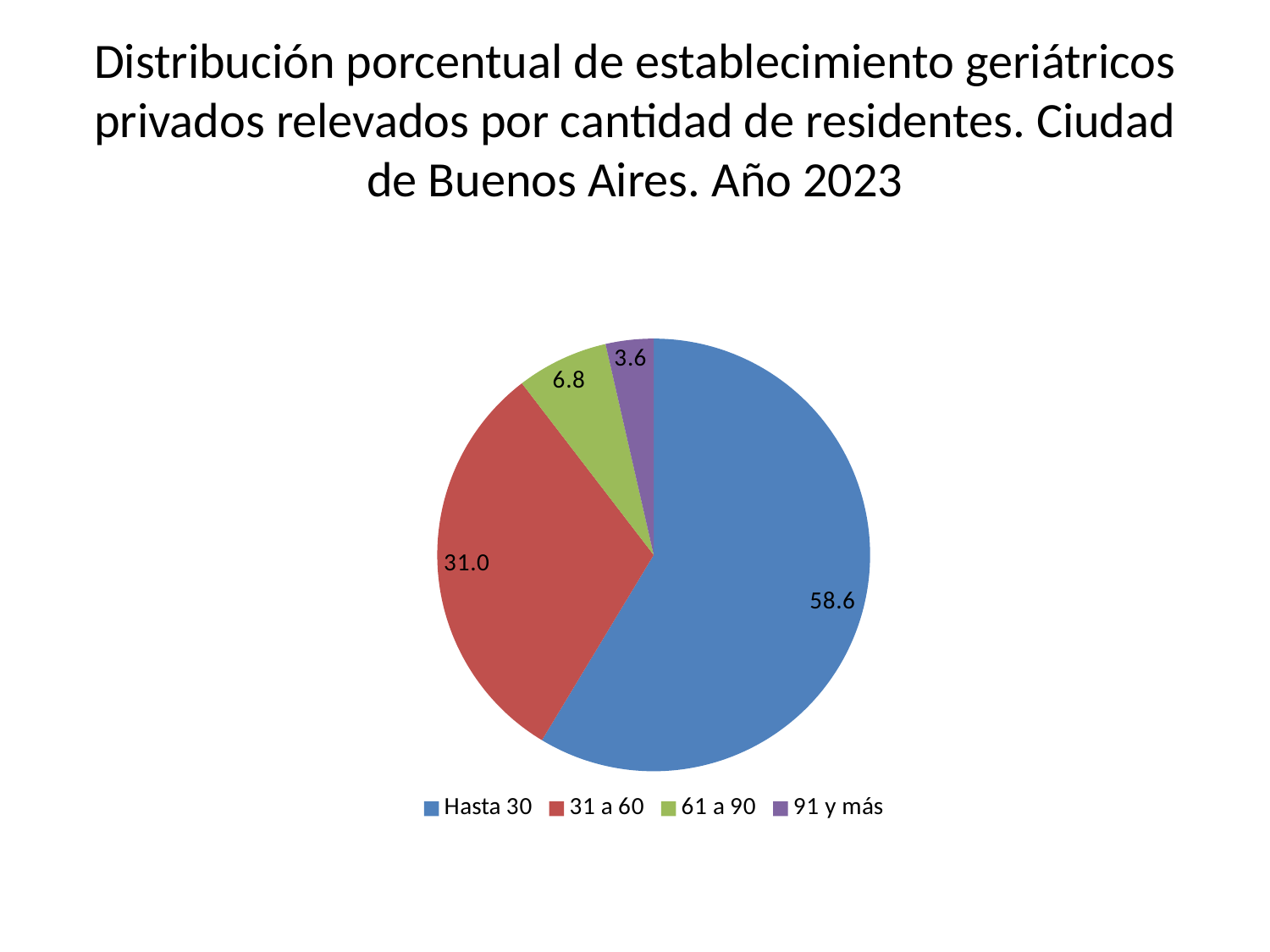
How many categories does the pie chart have? 4 What is the value for the '61 a 90' slice? 6.8 Which category has the largest slice? Hasta 30 Which category has the smallest slice? 91 y más What is the value for the 'Hasta 30' slice? 58.6 How many entries does the legend list? 4 Which is larger, the value for '61 a 90' or the value for '91 y más'? 61 a 90 What is the difference between the values for 'Hasta 30' and '31 a 60'? 27.6 What is the value for the '31 a 60' slice? 31.0 What kind of chart is shown on the slide? pie chart What colour is the 'Hasta 30' slice? blue What is the value for the '91 y más' slice? 3.6